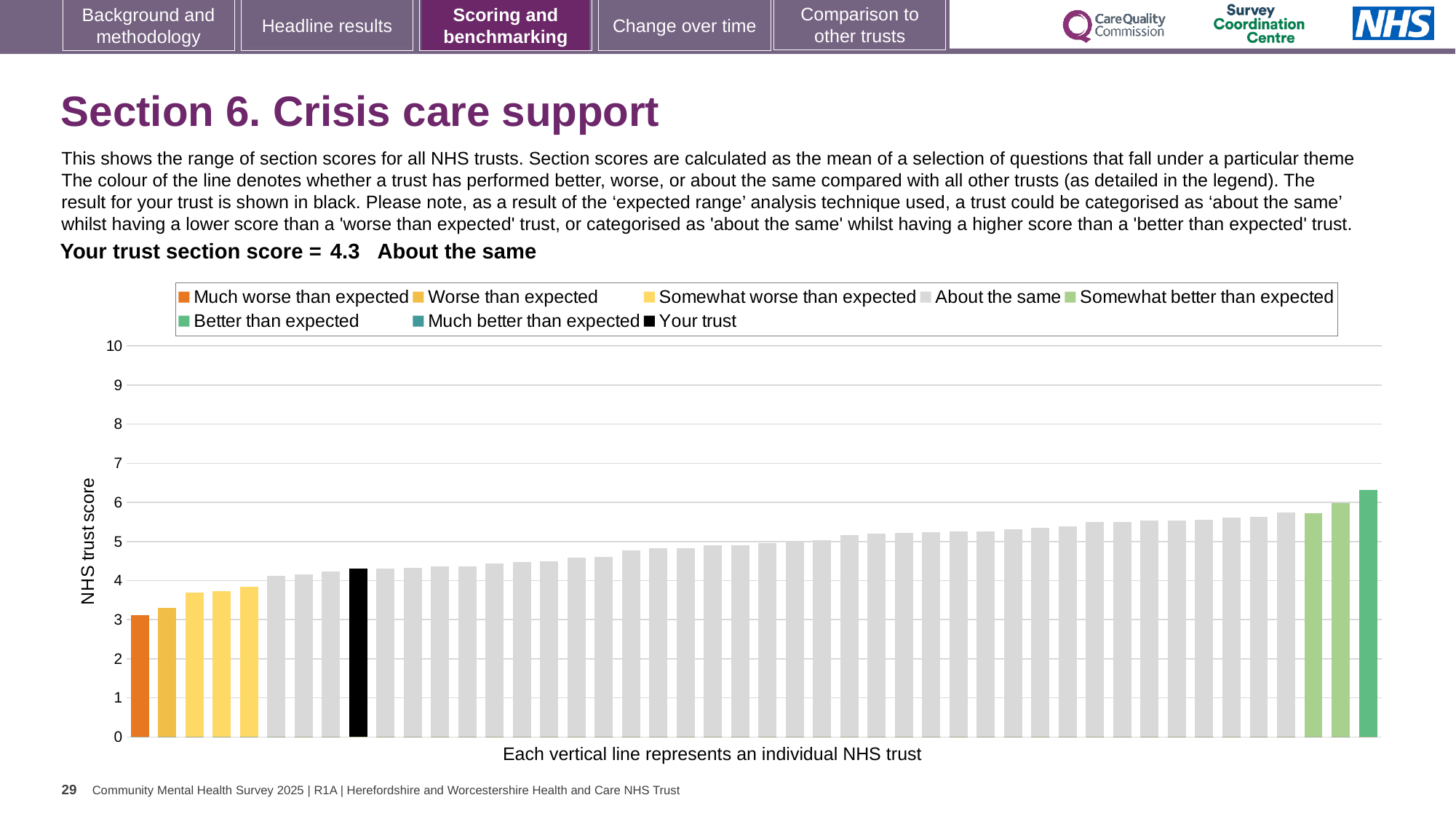
What is the section score for your trust, as printed on the slide? 4.3 What is the label on the vertical axis of the chart? NHS trust score Which performance category is your trust placed in, according to the text above the chart? About the same What kind of chart is shown on the slide? Bar chart How many bars are coloured as 'Somewhat worse than expected' (light yellow)? 3 Which bar has the lowest score: the orange 'Much worse than expected' bar or the black 'Your trust' bar? The orange 'Much worse than expected' bar Do the bar values rise or fall from left to right along the x axis? Rise Which category does the legend assign to the black bar? Your trust Is the value of the tallest bar (rightmost, green) greater or less than 6? greater Is the value of the leftmost orange bar greater or less than 4? less How many entries does the chart legend list? 8 Is the value of the black 'Your trust' bar greater or less than 5? less